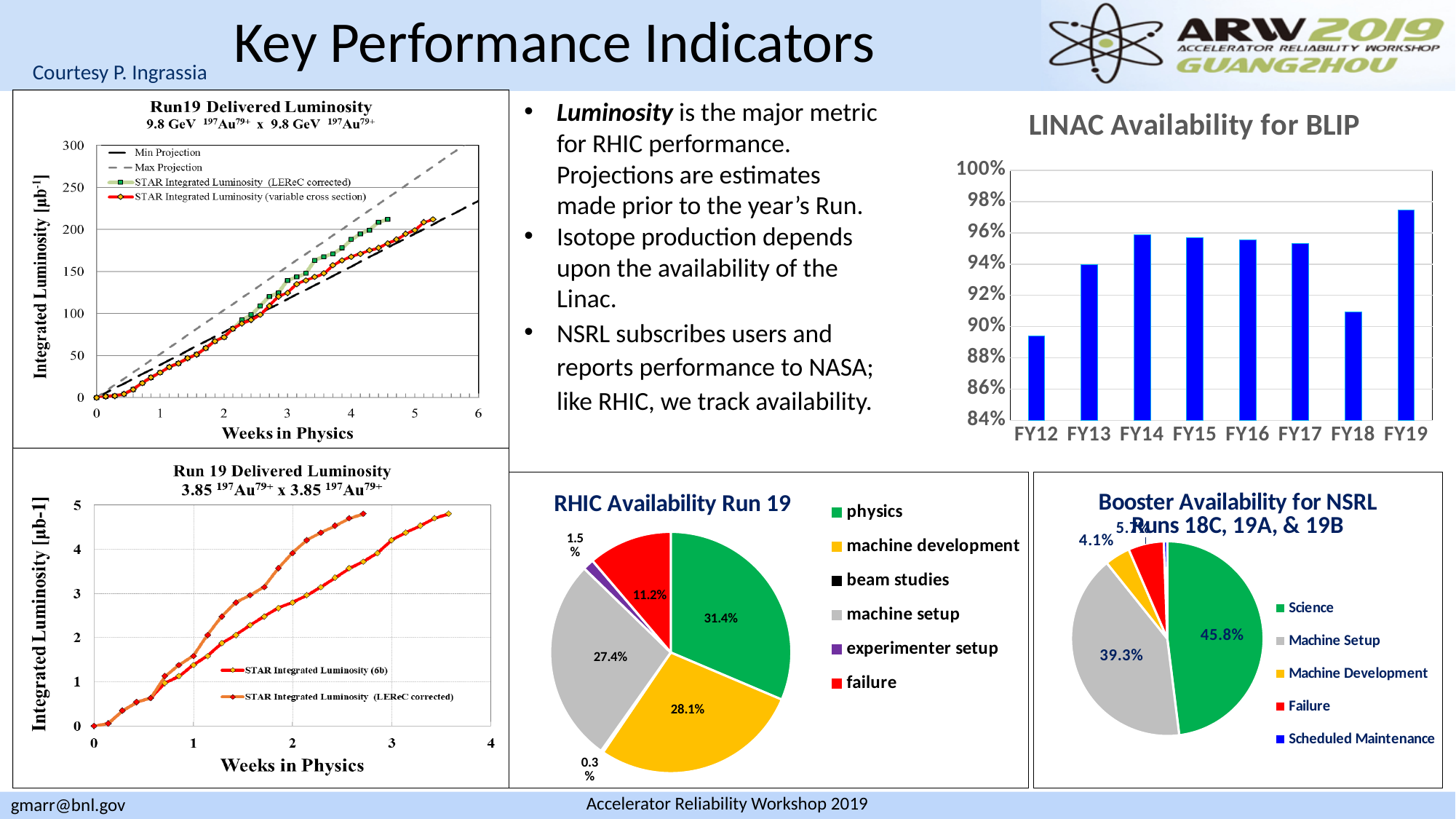
In the 'LINAC Availability for BLIP' chart, is the value for FY19 greater or less than 96%? greater In the 'LINAC Availability for BLIP' chart, which fiscal year has the highest availability? FY19 In the 'LINAC Availability for BLIP' chart, which is larger, the value for FY13 or FY18? FY13 In the 'Booster Availability for NSRL' pie chart, what share is Machine Setup? 39.3% In the 'LINAC Availability for BLIP' chart, is the value for FY12 greater or less than 90%? less In the 'LINAC Availability for BLIP' chart, which fiscal year has the lowest availability? FY12 In the 'RHIC Availability Run 19' pie chart, what is the difference between the physics share and the machine development share? 3.3% In the 'RHIC Availability Run 19' pie chart, what share is physics? 31.4% How many entries does the legend of the 'RHIC Availability Run 19' pie chart list? 6 What kind of chart is the 'LINAC Availability for BLIP' chart? bar chart In the 'LINAC Availability for BLIP' chart, how many fiscal years are shown? 8 How many series does the legend of the top-left 'Run19 Delivered Luminosity' chart list? 4